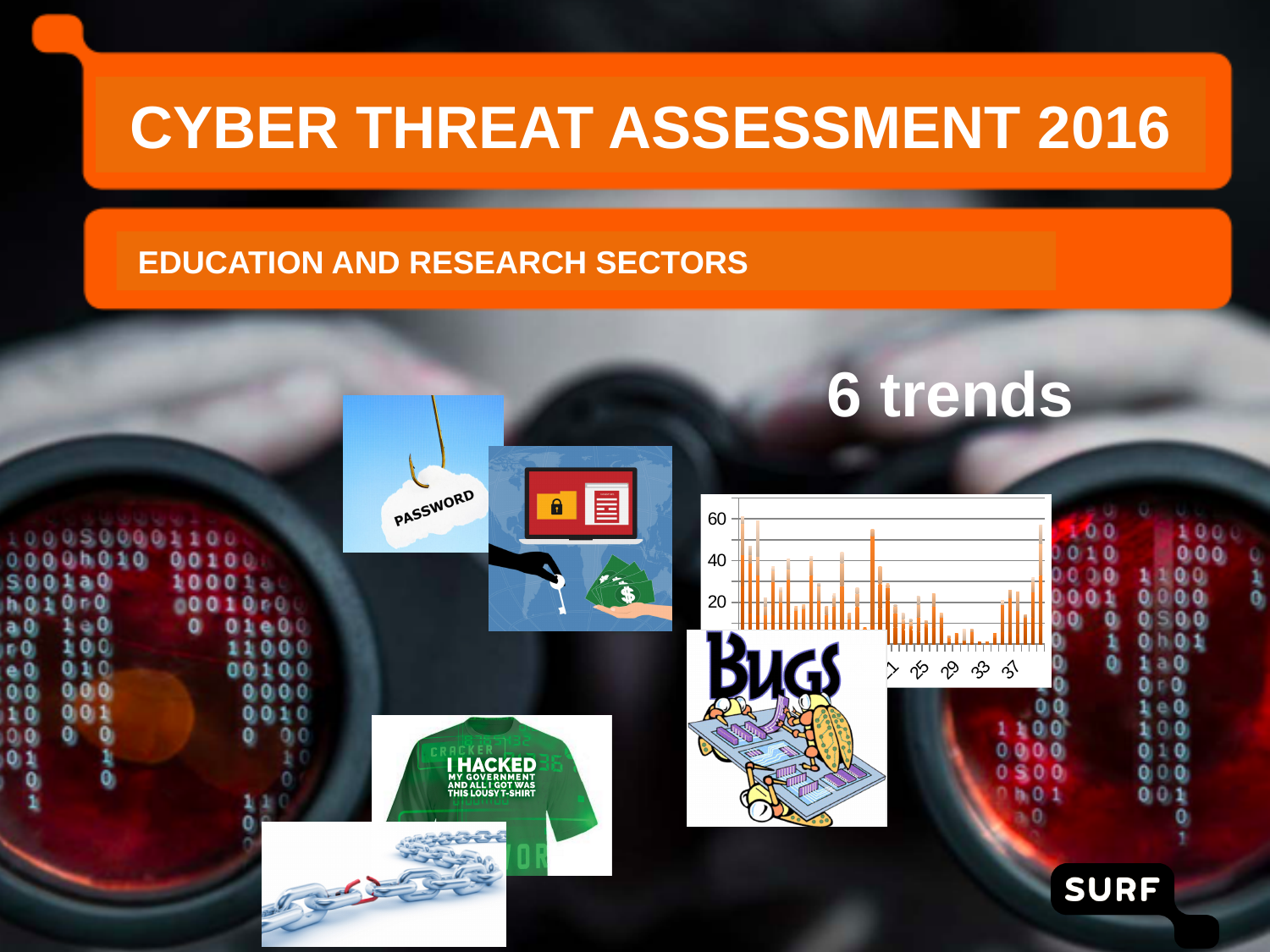
What is the highest value labelled on the chart's vertical axis? 60 What kind of chart is shown on the slide? bar chart Is the value of the tallest bar in the chart greater or less than 40? greater What colour are the bars in the chart? orange